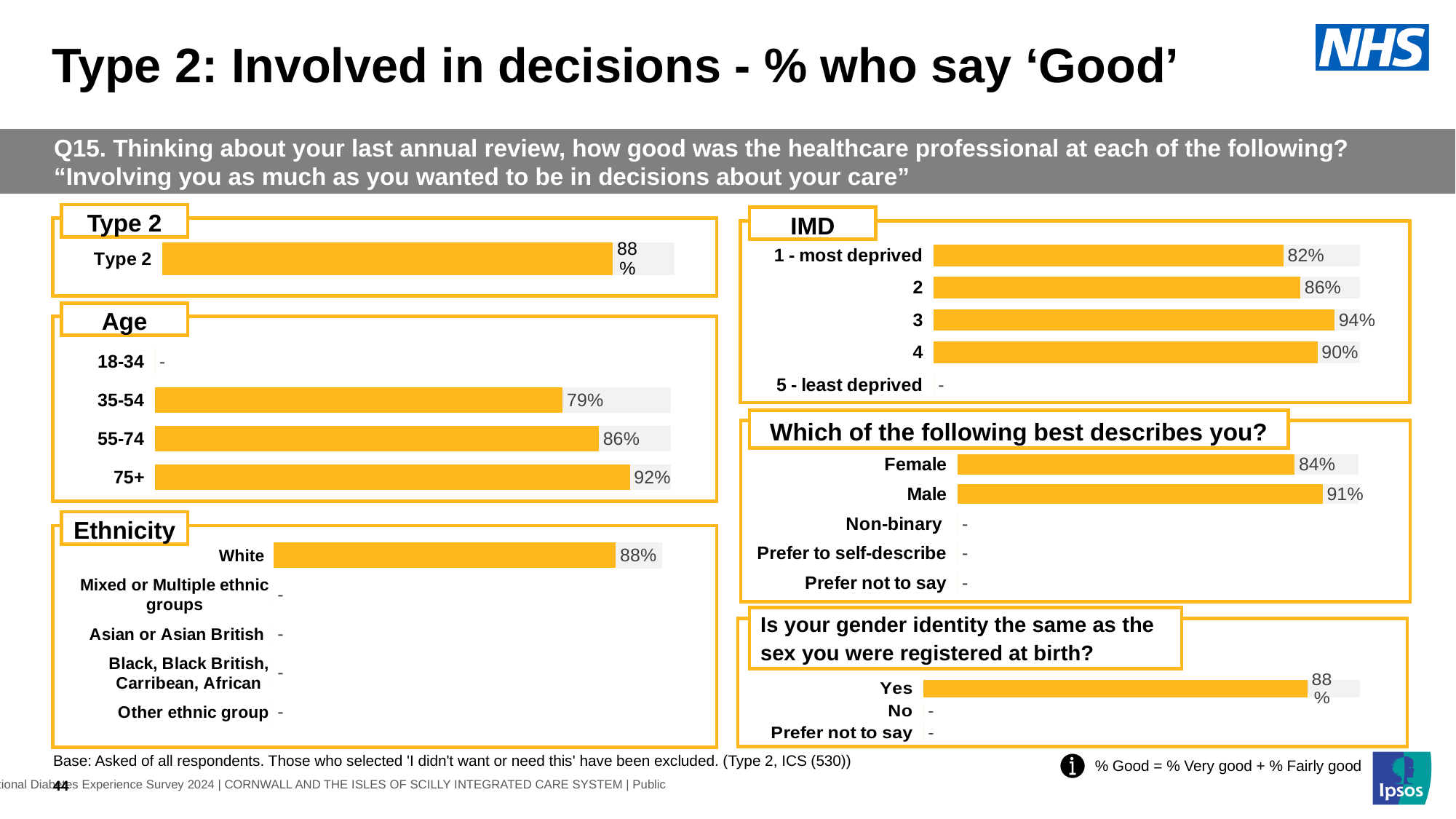
In the IMD chart, which IMD group has the highest value? 3 In the Age chart, what is the value for the 35-54 age group? 79% What type of chart is used in the IMD section? Bar chart In the Age chart, which age group with a plotted value has the highest value? 75+ In the Ethnicity chart, what is the value for White? 88% In the IMD chart, which IMD group with a plotted value has the lowest value? 1 - most deprived In the IMD chart, what is the difference between the values for IMD group 4 and IMD group 2? 4 percentage points In the 'Which of the following best describes you?' chart, what is the value for Female? 84% In the Type 2 chart, what is the value for Type 2? 88% In the 'Is your gender identity the same as the sex you were registered at birth?' chart, what is the value for Yes? 88% In the Age chart, what is the difference between the values for 75+ and 55-74? 6 percentage points In the 'Which of the following best describes you?' chart, which is larger, the value for Female or for Male? Male